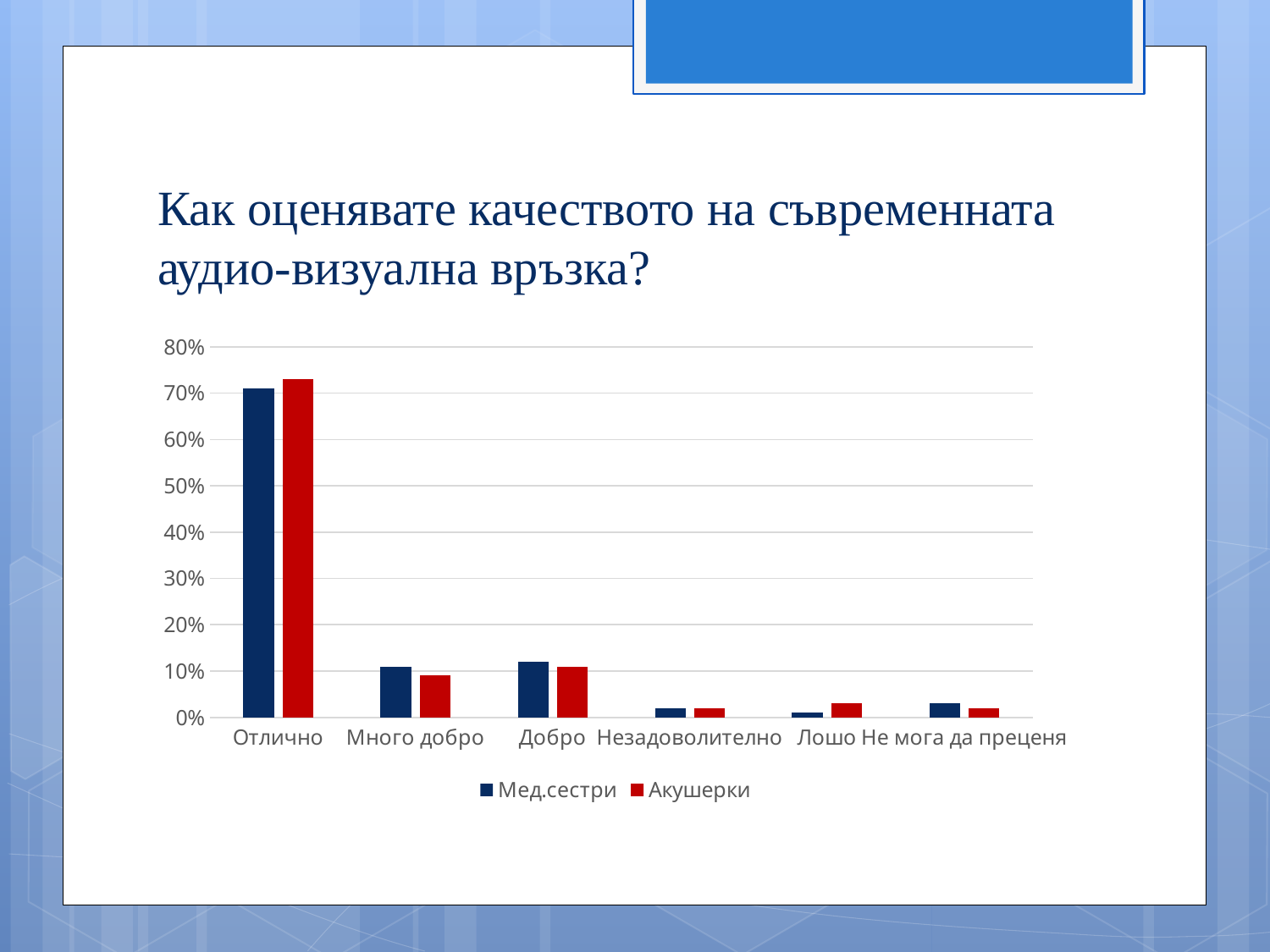
In the Много добро category, which series has the larger value, Мед.сестри or Акушерки? Мед.сестри Is the value for Мед.сестри in the Много добро category greater or less than 20%? less What kind of chart is shown on the slide? bar chart Which colour represents the Акушерки series in the chart? red Is the value for Акушерки in the Отлично category greater or less than 70%? greater Is the value for Мед.сестри in the Добро category greater or less than 10%? greater How many response categories are shown on the x axis? 6 Which category has the highest value for Мед.сестри? Отлично Which category has the highest value for Акушерки? Отлично How many series does the legend list? 2 In the Лошо category, which series has the larger value, Мед.сестри or Акушерки? Акушерки